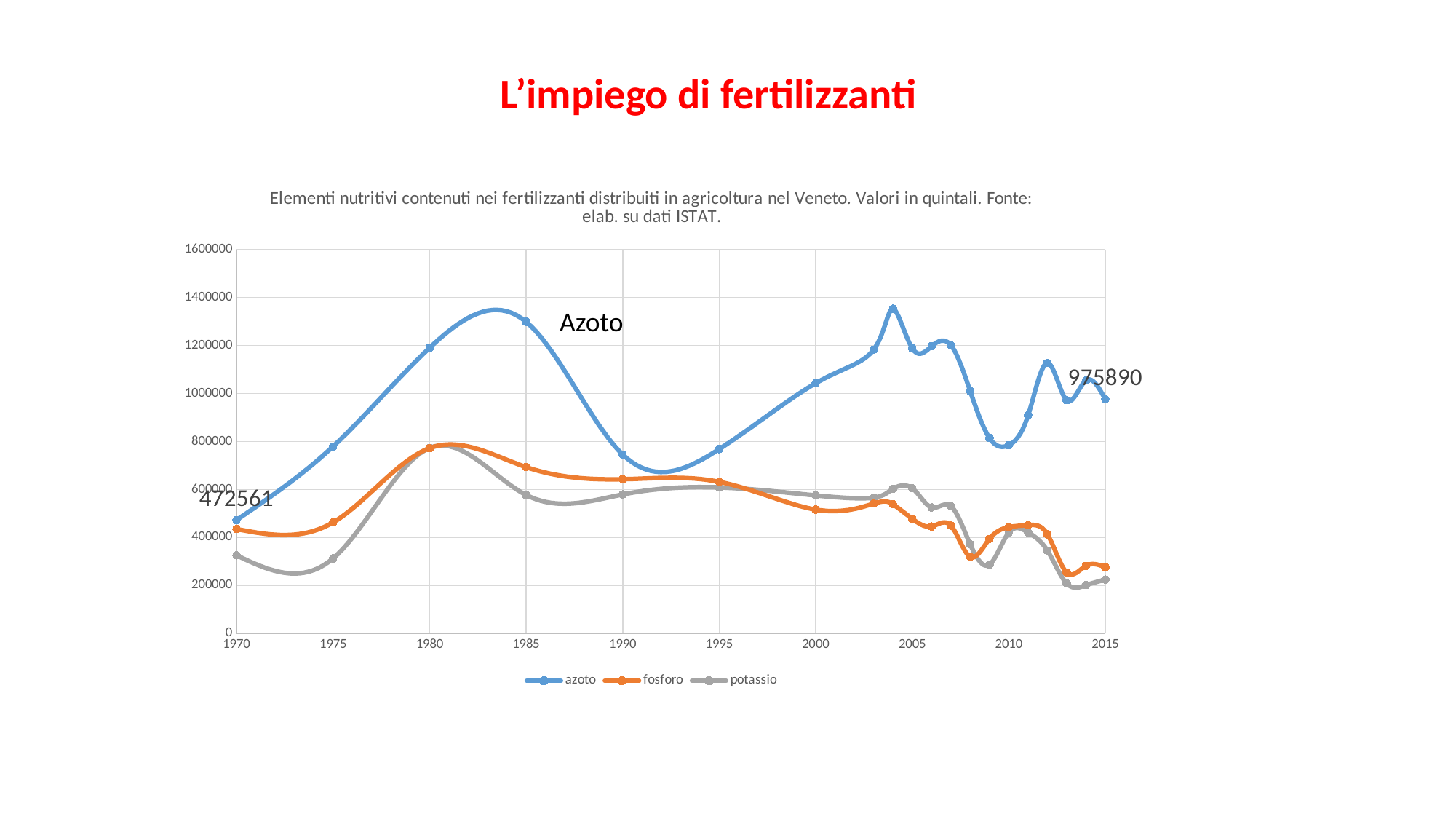
What are the three series listed in the legend? azoto, fosforo, potassio Is the value for potassio in 1970 greater or less than 400000? less What is the value of azoto in 1970? 472561 Which series has the lowest value in 1975? potassio How many series does the legend list? 3 What is the difference between the azoto value in 2015 and the azoto value in 1970? 503329 What kind of chart is shown on the slide? line chart Which series has the highest value in 2004? azoto In 1985, which is larger: the value for azoto or the value for fosforo? azoto What is the value of azoto in 2015? 975890 Does the azoto series rise or fall between 1970 and 1980? rise Is the value for azoto in 1980 greater or less than 1000000? greater